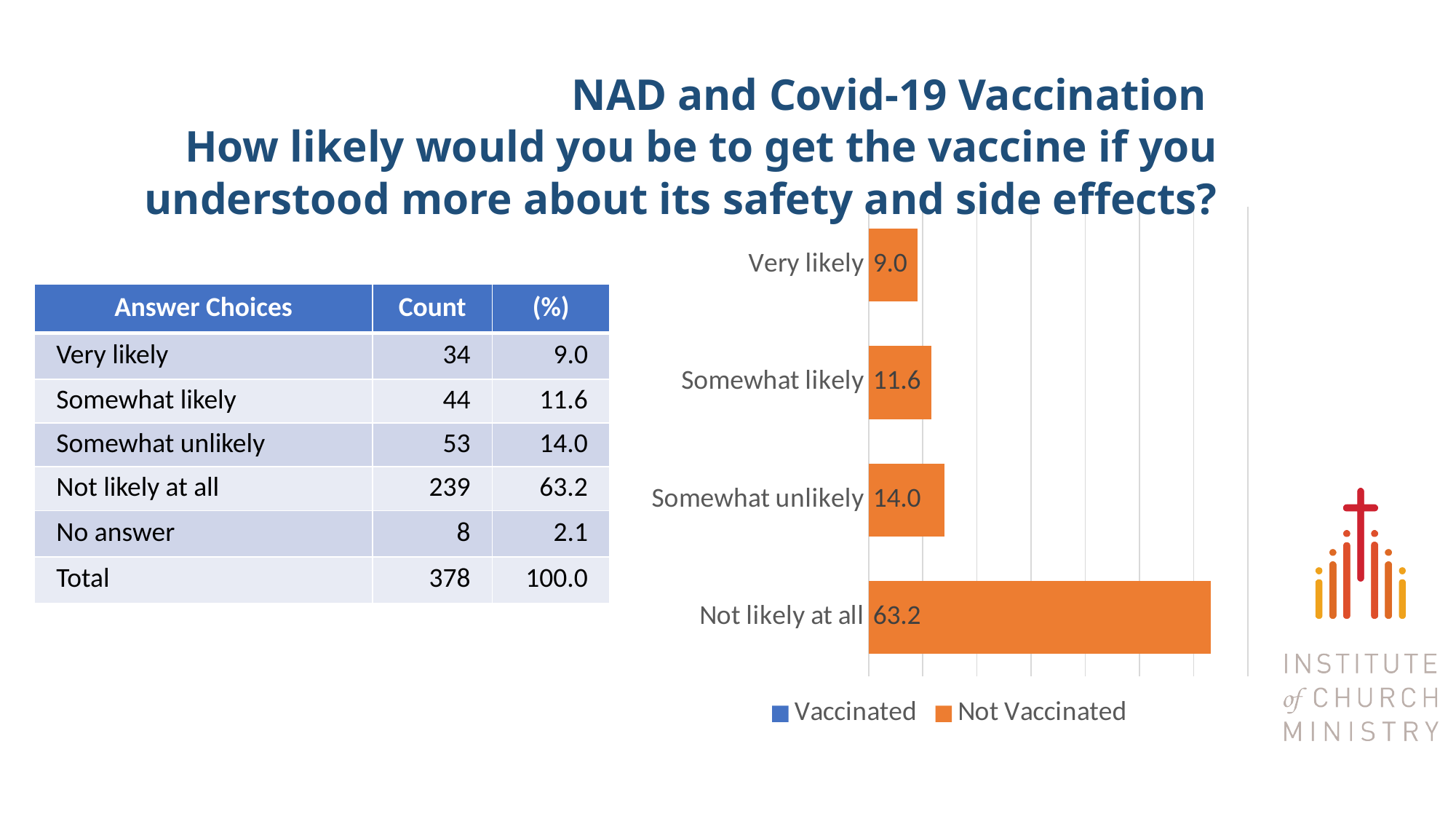
What is the value for Somewhat unlikely in the chart? 14.0 What is the difference between the values for Not likely at all and Somewhat unlikely? 49.2 What is the value for Somewhat likely in the chart? 11.6 What kind of chart is shown on the slide? Bar chart Which is larger, the value for Somewhat unlikely or the value for Somewhat likely? Somewhat unlikely Which category has the highest value in the chart? Not likely at all Which category has the lowest value in the chart? Very likely What is the difference between the values for Somewhat likely and Very likely? 2.6 What is the value for Very likely in the chart? 9.0 How many categories are plotted in the chart? 4 How many series does the chart legend list? 2 What is the value for Not likely at all in the chart? 63.2